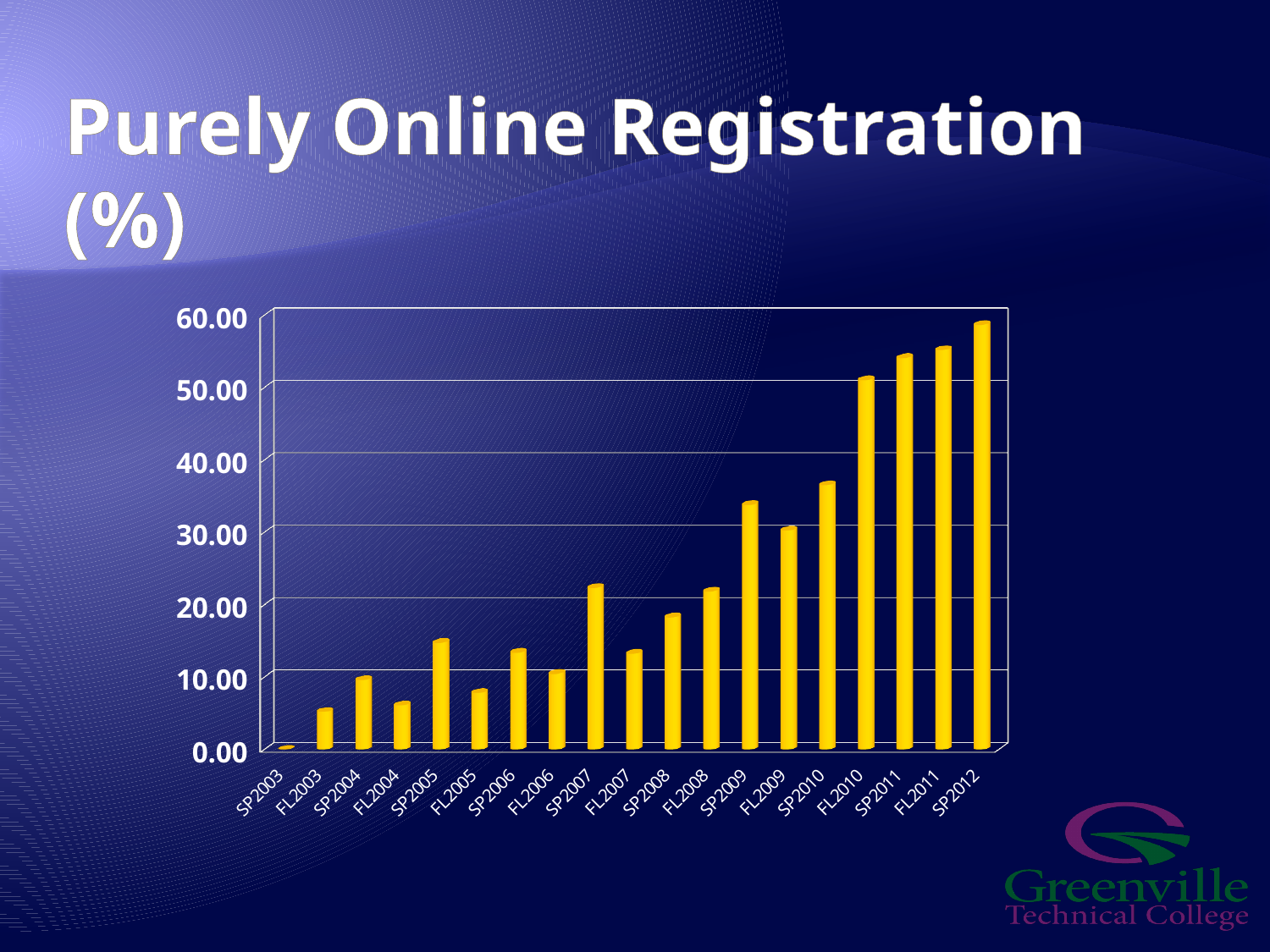
Which is larger, the value for FL2010 or the value for SP2010? FL2010 How many terms (categories) are plotted along the x axis? 19 Which term has the highest purely online registration percentage? SP2012 Is the value for FL2005 greater or less than 10.00? less Is the value for FL2010 greater or less than 50.00? greater Which is larger, the value for SP2007 or the value for FL2007? SP2007 Is the value for SP2007 greater or less than 20.00? greater Overall, do the values rise or fall from SP2003 to SP2012? rise Which term has the lowest purely online registration percentage? SP2003 What is the title of the chart on the slide? Purely Online Registration (%) What kind of chart is shown on the slide? bar chart